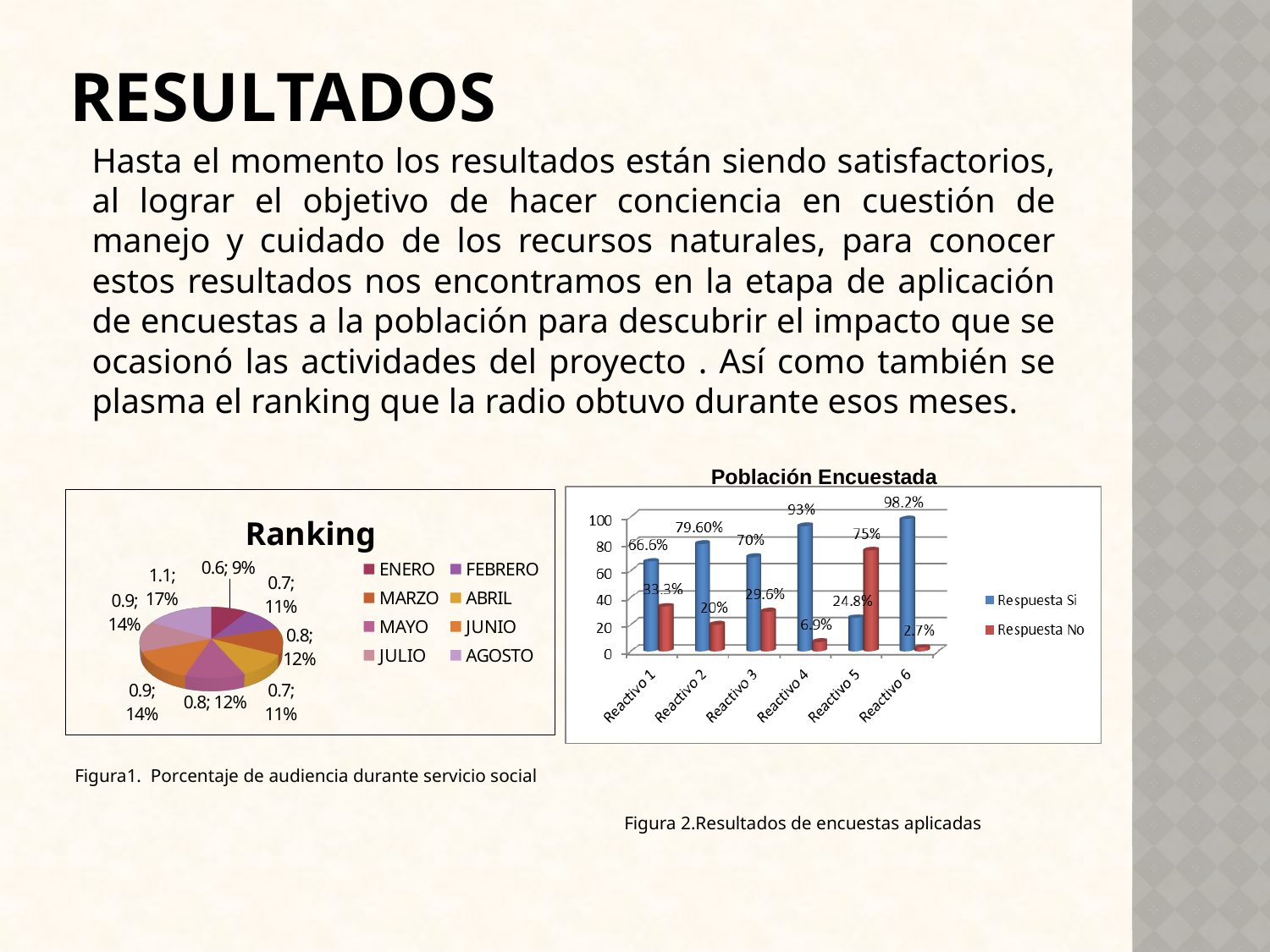
What kind of chart is the 'Ranking' chart? pie chart In the 'Población Encuestada' chart, which Reactivo has the highest Respuesta Si value? Reactivo 6 How many series does the legend of the 'Población Encuestada' chart list? 2 What kind of chart is the 'Población Encuestada' chart? bar chart How many Reactivo categories are shown in the 'Población Encuestada' chart? 6 In the 'Población Encuestada' chart, what is the Respuesta Si value for Reactivo 4? 93% How many months does the legend of the 'Ranking' chart list? 8 In the 'Población Encuestada' chart, what is the Respuesta No value for Reactivo 5? 75% In the 'Población Encuestada' chart, which is larger for Reactivo 5: Respuesta Si or Respuesta No? Respuesta No In the 'Población Encuestada' chart, what is the difference between Respuesta Si and Respuesta No for Reactivo 1? 33.3% In the 'Población Encuestada' chart, which Reactivo has the lowest Respuesta Si value? Reactivo 5 In the 'Población Encuestada' chart, what is the Respuesta No value for Reactivo 6? 2.7%